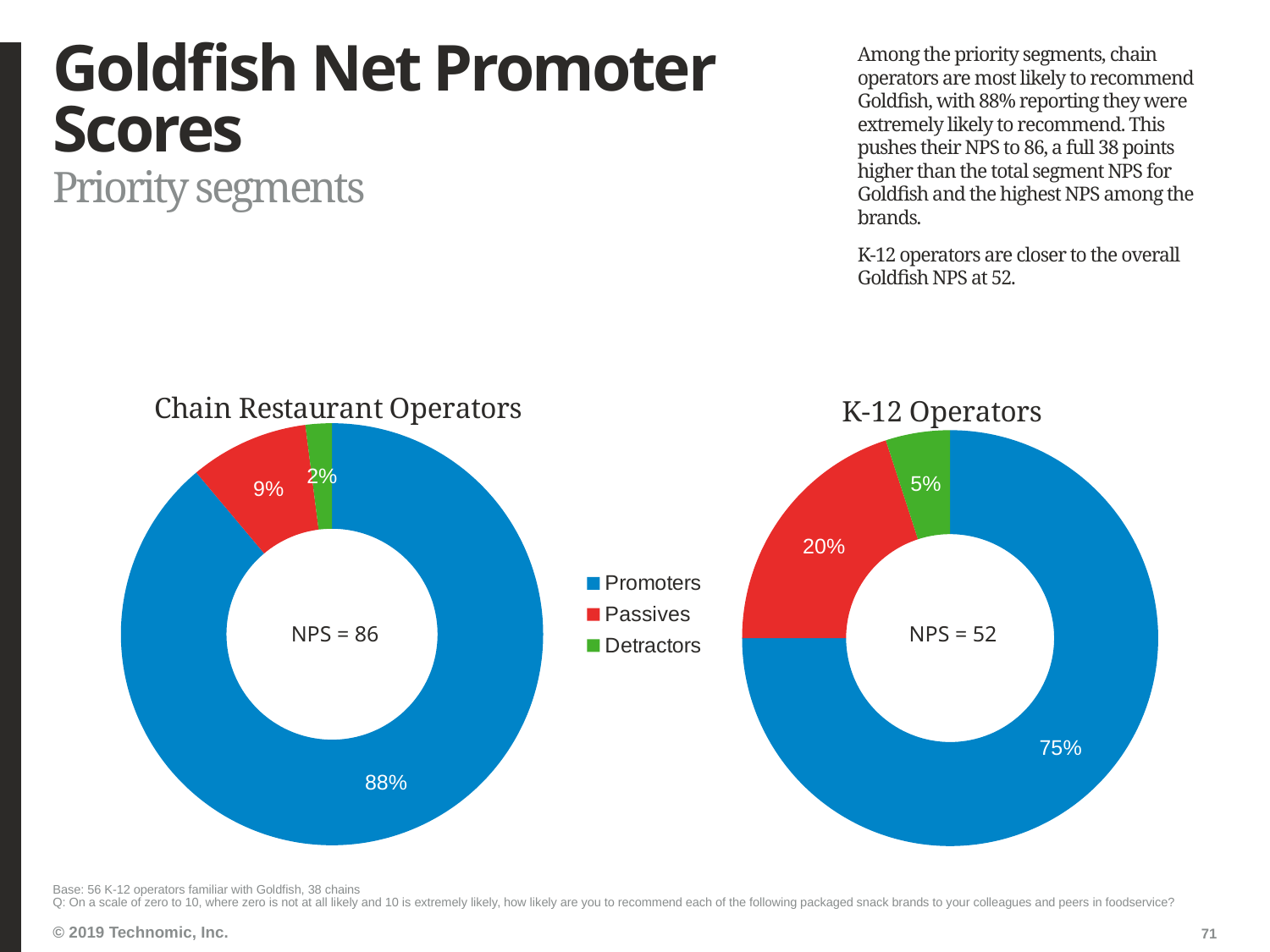
In the K-12 Operators chart, what percentage are Detractors? 5% In the Chain Restaurant Operators chart, what percentage are Passives? 9% What NPS value is shown in the center of the K-12 Operators chart? NPS = 52 How many series does the legend list? 3 In the K-12 Operators chart, which category has the largest share? Promoters Which is larger: the Passives share for Chain Restaurant Operators or the Passives share for K-12 Operators? K-12 Operators In the K-12 Operators chart, what percentage are Passives? 20% What is the difference between the Promoters share in the Chain Restaurant Operators chart and the Promoters share in the K-12 Operators chart? 13% In the Chain Restaurant Operators chart, what percentage are Promoters? 88% In the Chain Restaurant Operators chart, which category has the smallest share? Detractors What colour represents Detractors in the legend? Green What type of chart is used for the Chain Restaurant Operators data? Doughnut chart